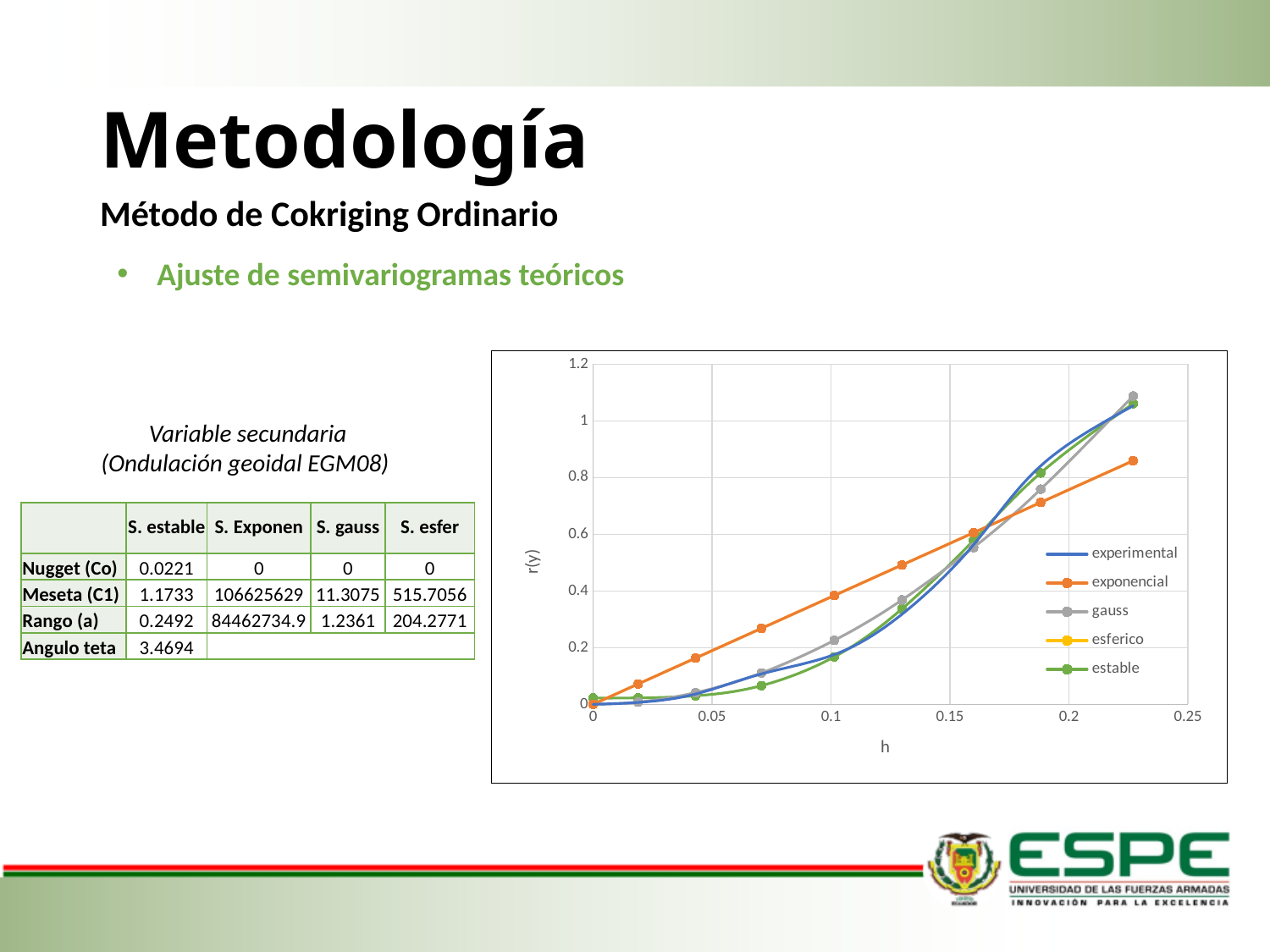
Do the values of the exponencial series rise or fall as h increases? rise At h = 0.05, which series has the higher value, exponencial or estable? exponencial At the rightmost data point, which series has the higher value, gauss or exponencial? gauss What kind of chart is shown on the slide? line chart Is the value of the exponencial series at its rightmost point greater or less than 1? less Is the value of the gauss series at its rightmost point greater or less than 1? greater How many series does the chart legend list? 5 Is the value of the exponencial series at h = 0.15 greater or less than 0.8? less What are the series names listed in the chart legend? experimental, exponencial, gauss, esferico, estable What is the label of the x axis of the chart? h